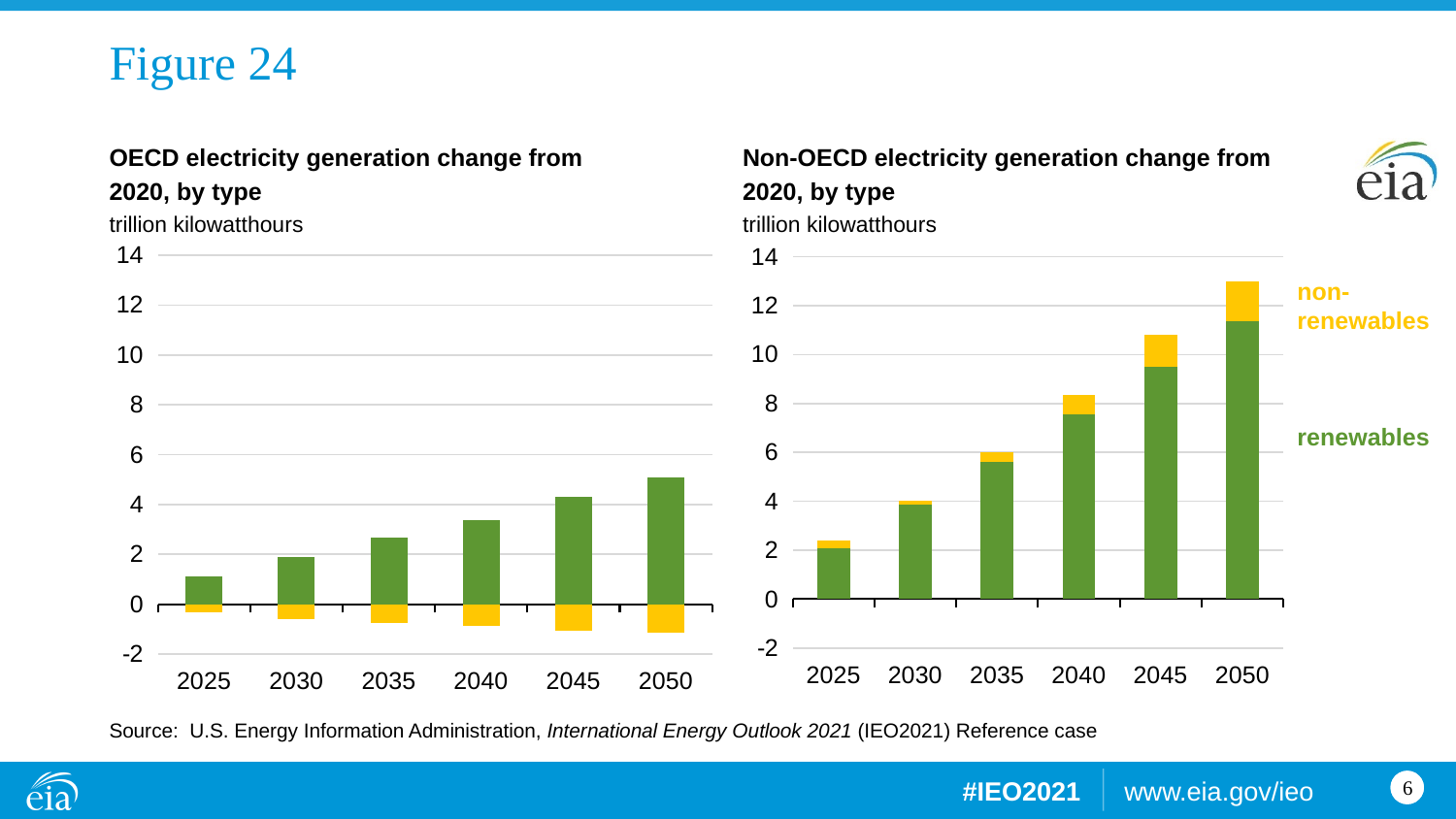
How many series does the legend of the 'Non-OECD electricity generation change from 2020, by type' chart list? 2 In the 'Non-OECD electricity generation change from 2020, by type' chart, is the renewables value for 2040 greater or less than 6? greater In the 'OECD electricity generation change from 2020, by type' chart, do the renewables values rise or fall from 2025 to 2050? rise In the 'Non-OECD electricity generation change from 2020, by type' chart, is the renewables value for 2050 greater or less than 10? greater How many years are shown on the x axis of the 'Non-OECD electricity generation change from 2020, by type' chart? 6 What unit is used on the y axis of both charts? trillion kilowatthours In the 'OECD electricity generation change from 2020, by type' chart, is the renewables value for 2025 greater or less than 2? less Which chart shows the larger renewables value for 2050, the OECD chart or the Non-OECD chart? Non-OECD In the 'Non-OECD electricity generation change from 2020, by type' chart, which year has the tallest stacked bar? 2050 What kind of chart is the 'OECD electricity generation change from 2020, by type' chart? bar chart In the 'OECD electricity generation change from 2020, by type' chart, which year has the smallest renewables bar? 2025